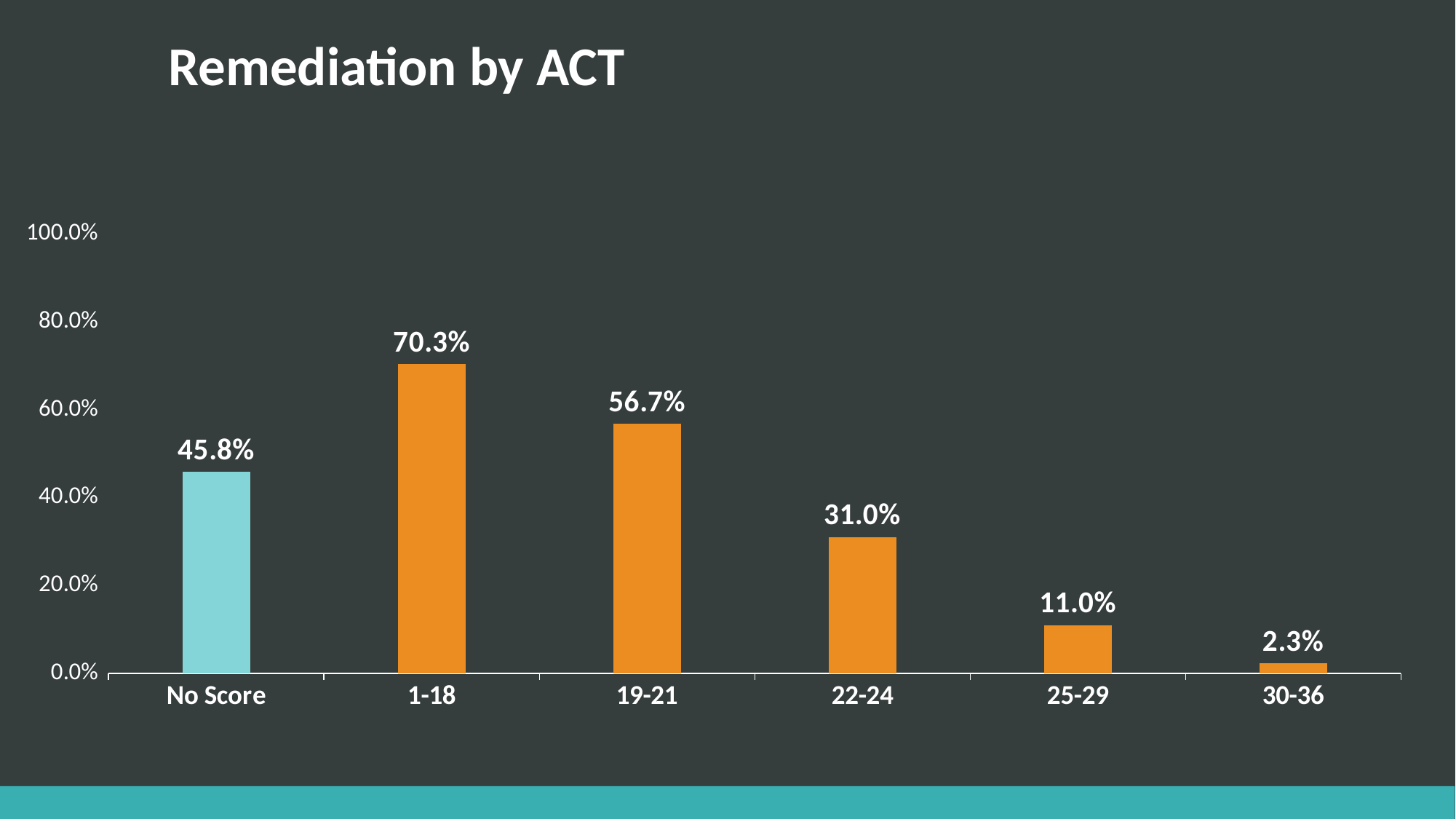
Do the remediation rates rise or fall from the 1-18 category to the 30-36 category? Fall Which ACT score category has the highest remediation rate? 1-18 Which ACT score category has the lowest remediation rate? 30-36 How many ACT score categories are shown on the chart? 6 What is the difference between the remediation rates for 1-18 and 19-21? 13.6% What is the remediation rate for the 30-36 ACT score range? 2.3% What is the difference between the remediation rates for 22-24 and 25-29? 20.0% What is the remediation rate for the 1-18 ACT score range? 70.3% What is the remediation rate for the 22-24 ACT score range? 31.0% What is the remediation rate for students with No Score? 45.8% Which has a higher remediation rate, No Score or 19-21? 19-21 What kind of chart is shown on the slide? Bar chart